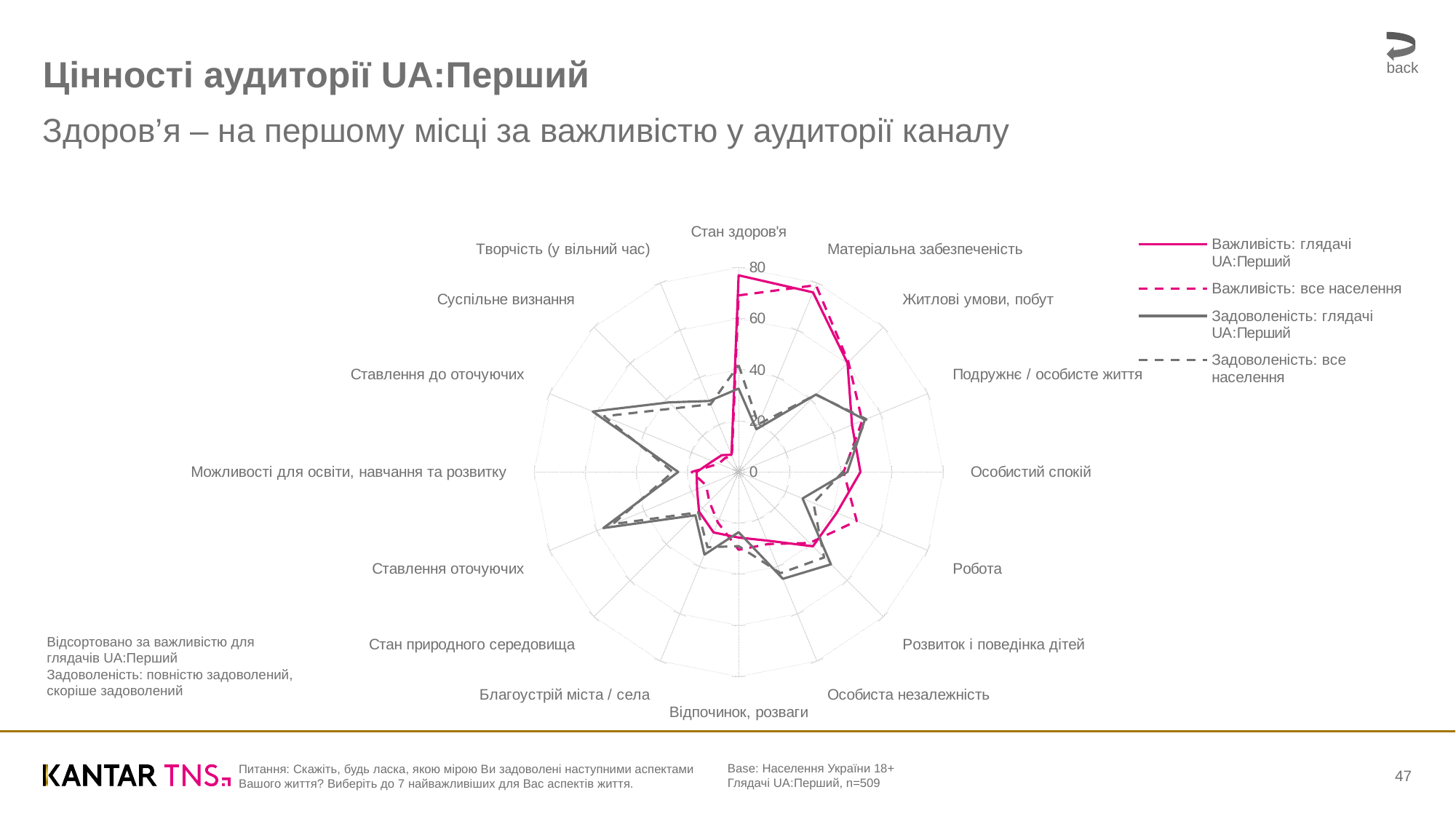
Is the satisfaction value for UA:Перший viewers on Ставлення до оточуючих greater or less than 40? greater Is the importance value for UA:Перший viewers on Стан здоров'я greater or less than 60? greater Is the satisfaction value for UA:Перший viewers on Стан здоров'я greater or less than 40? less What is the highest value shown on the radar chart's axis scale? 80 What kind of chart is shown on the slide? radar chart For Стан здоров'я, which is larger for UA:Перший viewers: importance or satisfaction? importance How many categories (axes) does the radar chart have? 16 For UA:Перший viewers, which category has the larger importance value: Стан здоров'я or Робота? Стан здоров'я Which category has the highest importance value for UA:Перший viewers? Стан здоров'я How many series does the legend list? 4